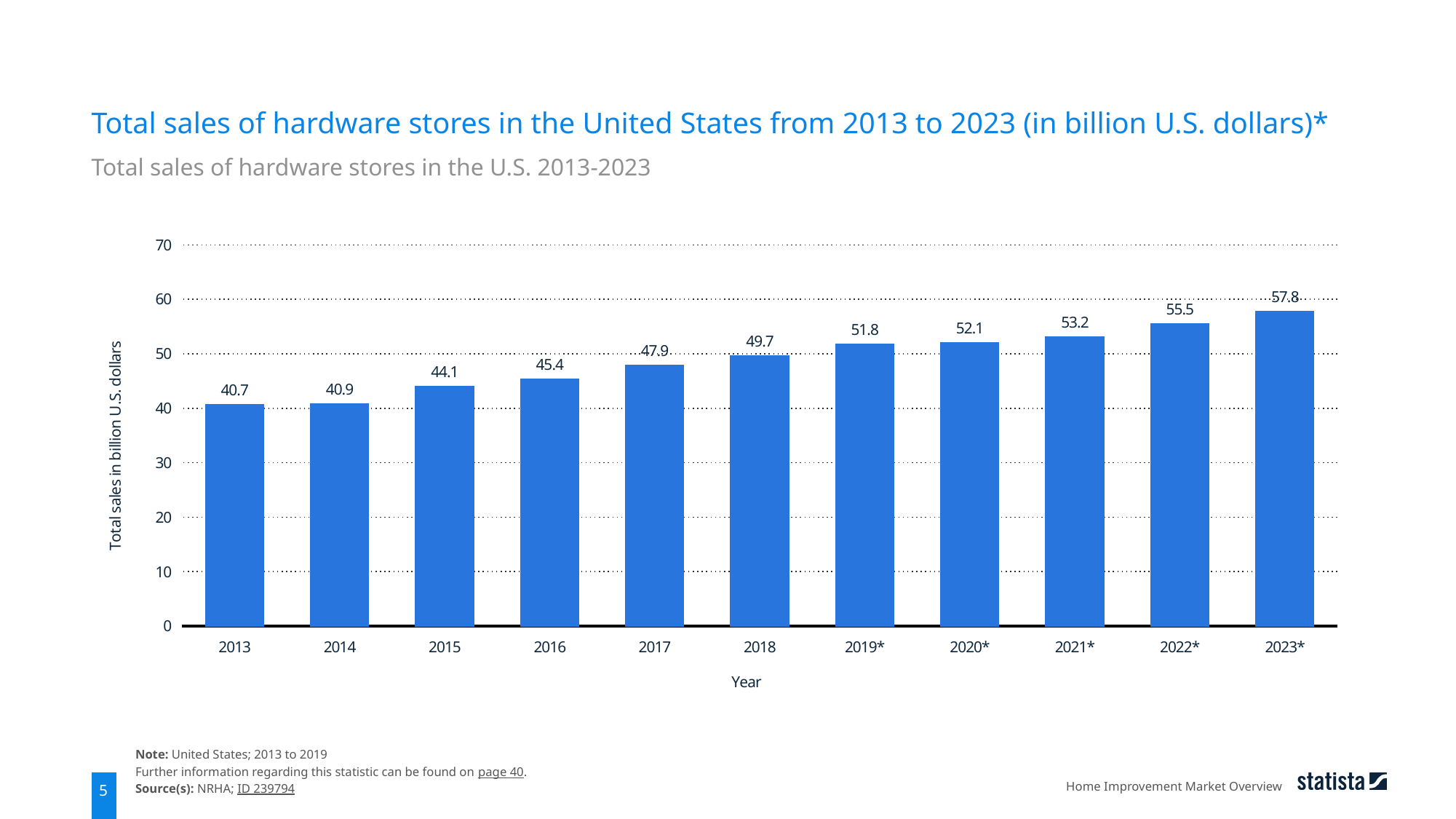
Which is larger, the value for 2019* or the value for 2018? 2019* What is the difference between the values for 2017 and 2016? 2.5 Which year has the lowest total sales? 2013 Which year has the highest total sales? 2023* What value is shown for 2021*? 53.2 How many years are shown on the x axis? 11 What is the difference between the values for 2023* and 2013? 17.1 Is the value for 2022* greater or less than 50? greater Do the values rise or fall from 2013 to 2023*? rise What value is shown for 2018? 49.7 What were the total sales of hardware stores in the United States in 2013? 40.7 What kind of chart is shown on the slide? bar chart